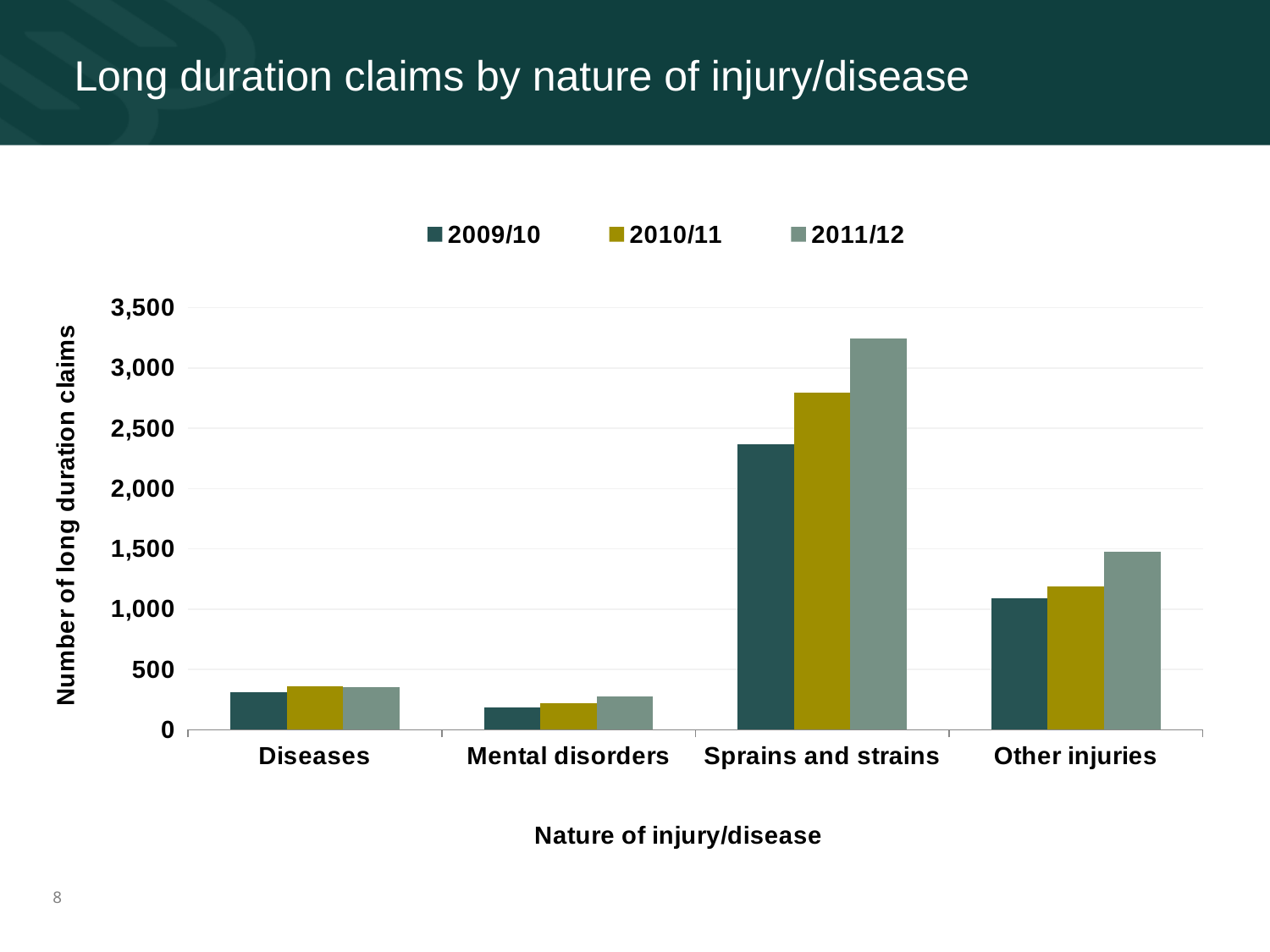
What is the title of the vertical axis? Number of long duration claims Is the value for Diseases in 2009/10 greater or less than 500? less Which is larger in 2011/12: the value for Other injuries or the value for Diseases? Other injuries Which category has the highest number of long duration claims in 2011/12? Sprains and strains How many series does the legend list? 3 Which category has the lowest number of long duration claims in 2009/10? Mental disorders How many nature of injury/disease categories are shown on the x axis? 4 Is the value for Sprains and strains in 2011/12 greater or less than 3,000? greater Is the value for Sprains and strains in 2009/10 greater or less than 2,500? less Do the values for Sprains and strains rise or fall from 2009/10 to 2011/12? rise What kind of chart is shown on the slide? bar chart